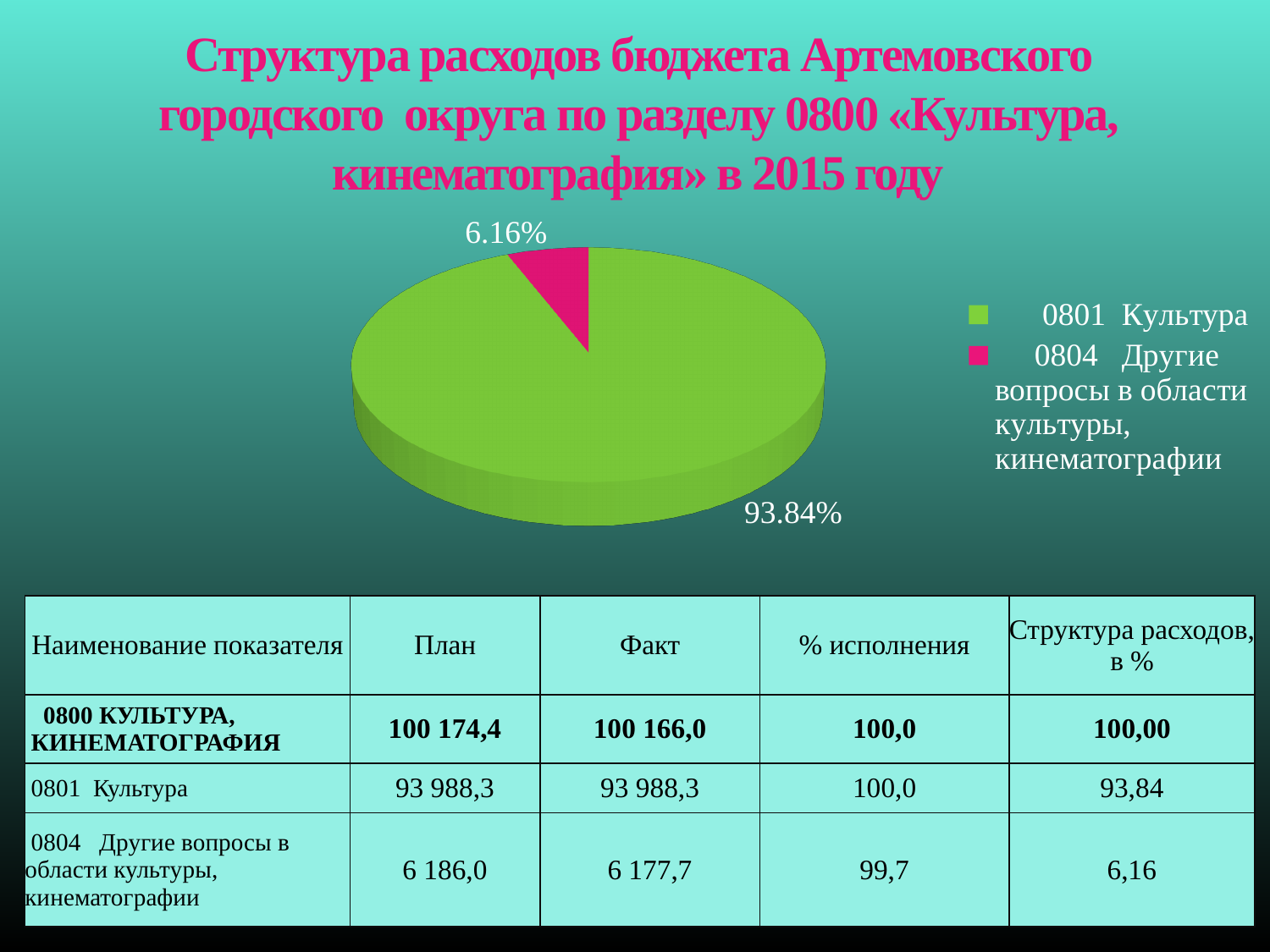
What colour is the slice for 0804 Другие вопросы в области культуры, кинематографии? pink How many entries does the legend list? 2 How many slices does the pie chart have? 2 What is the difference in percentage points between the 0801 Культура slice and the 0804 slice? 87.68 Which category has the largest slice of the pie? 0801 Культура What share of the pie does the slice for 0804 Другие вопросы в области культуры, кинематографии represent? 6.16% Which slice is larger: 0801 Культура or 0804 Другие вопросы в области культуры, кинематографии? 0801 Культура Which category has the smallest slice of the pie? 0804 Другие вопросы в области культуры, кинематографии What share of the pie does the slice for 0801 Культура represent? 93.84% What colour is the slice for 0801 Культура? green What kind of chart is shown on the slide? pie chart